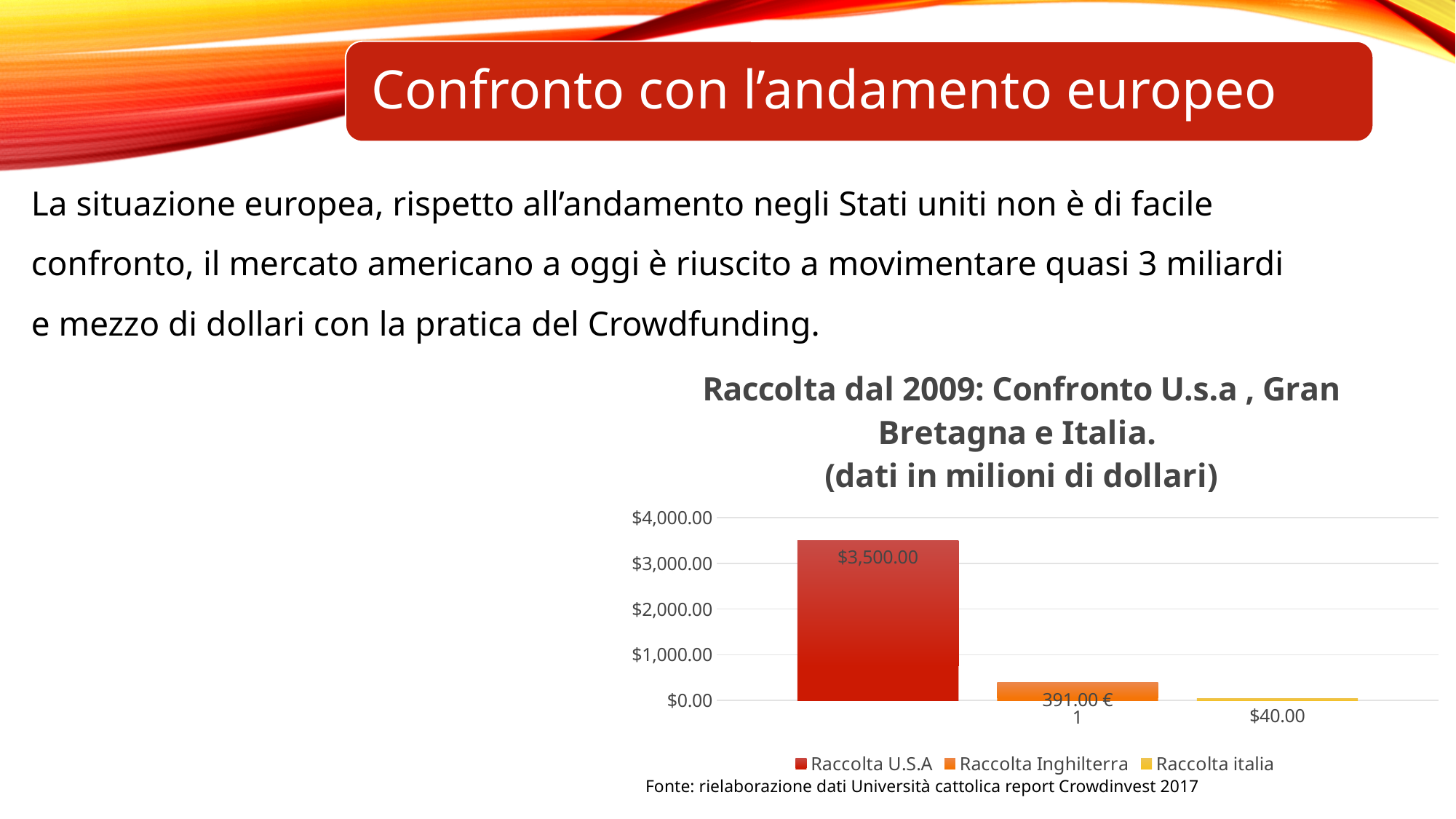
What kind of chart is shown on the slide? bar chart What is the value shown for Raccolta italia? $40.00 What is the value shown for Raccolta Inghilterra? 391.00 € How many series does the legend list? 3 What is the title of the chart? Raccolta dal 2009: Confronto U.s.a , Gran Bretagna e Italia. (dati in milioni di dollari) Is the value for Raccolta U.S.A greater or less than $3,000.00? greater Which series has the lowest value? Raccolta italia Which is larger, Raccolta Inghilterra or Raccolta italia? Raccolta Inghilterra Which series has the highest value? Raccolta U.S.A Is the value for Raccolta Inghilterra greater or less than $1,000.00? less What is the difference between the Raccolta U.S.A value and the Raccolta italia value? $3,460.00 What is the value shown for Raccolta U.S.A? $3,500.00